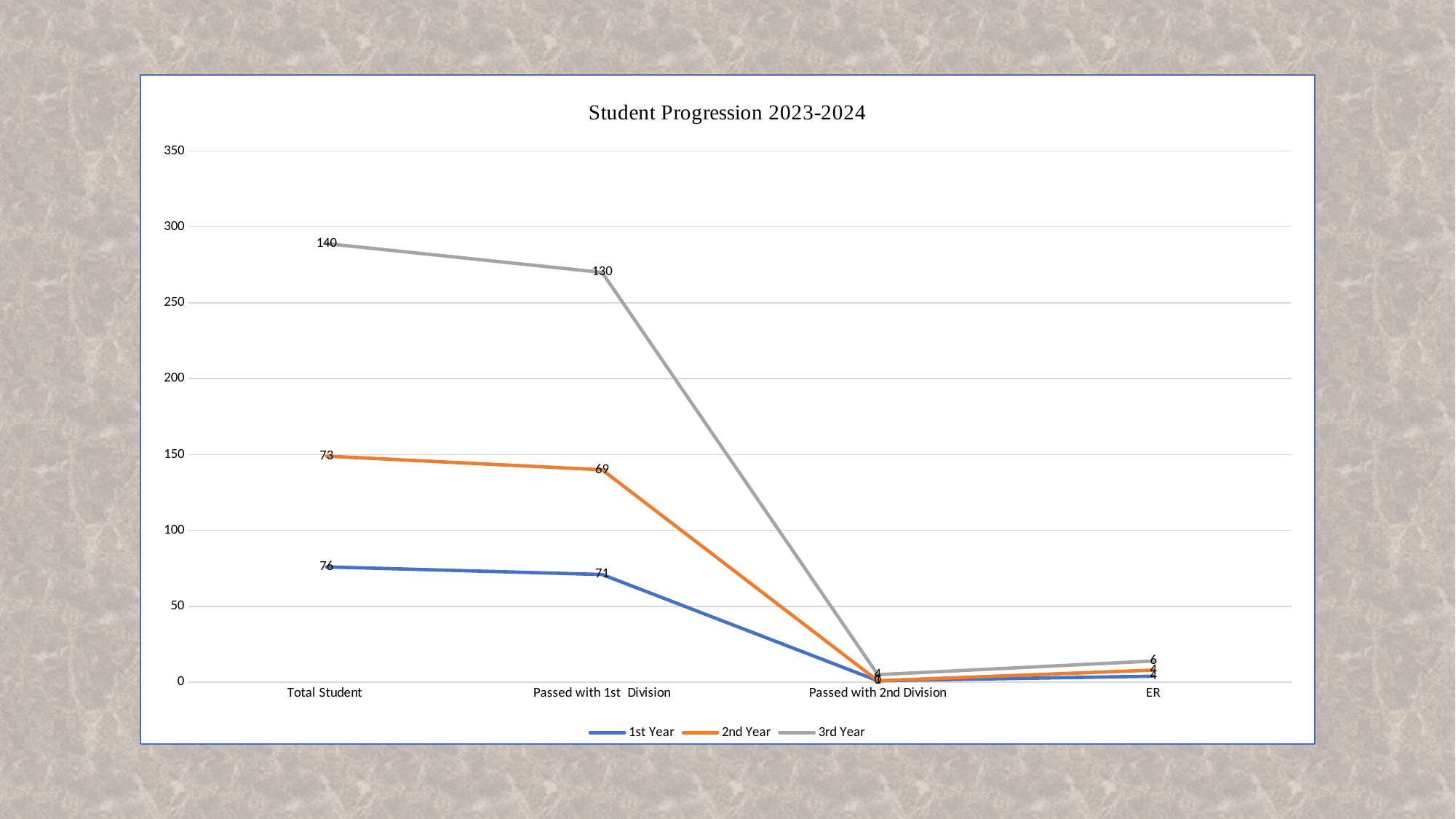
Which series has the larger value at Total Student, 1st Year or 3rd Year? 3rd Year What is the value for 3rd Year at Total Student? 140 What is the value for 2nd Year at Passed with 1st Division? 69 Which series has the highest value at Passed with 1st Division? 3rd Year What is the title of the chart? Student Progression 2023-2024 What is the value for 1st Year at Total Student? 76 Does the 3rd Year line rise or fall from Total Student to Passed with 2nd Division? fall How many series does the legend list? 3 What is the difference between the 3rd Year values at Total Student and Passed with 1st Division? 10 How many categories are shown on the x axis? 4 What kind of chart is shown on the slide? line chart What is the value for 3rd Year at ER? 6